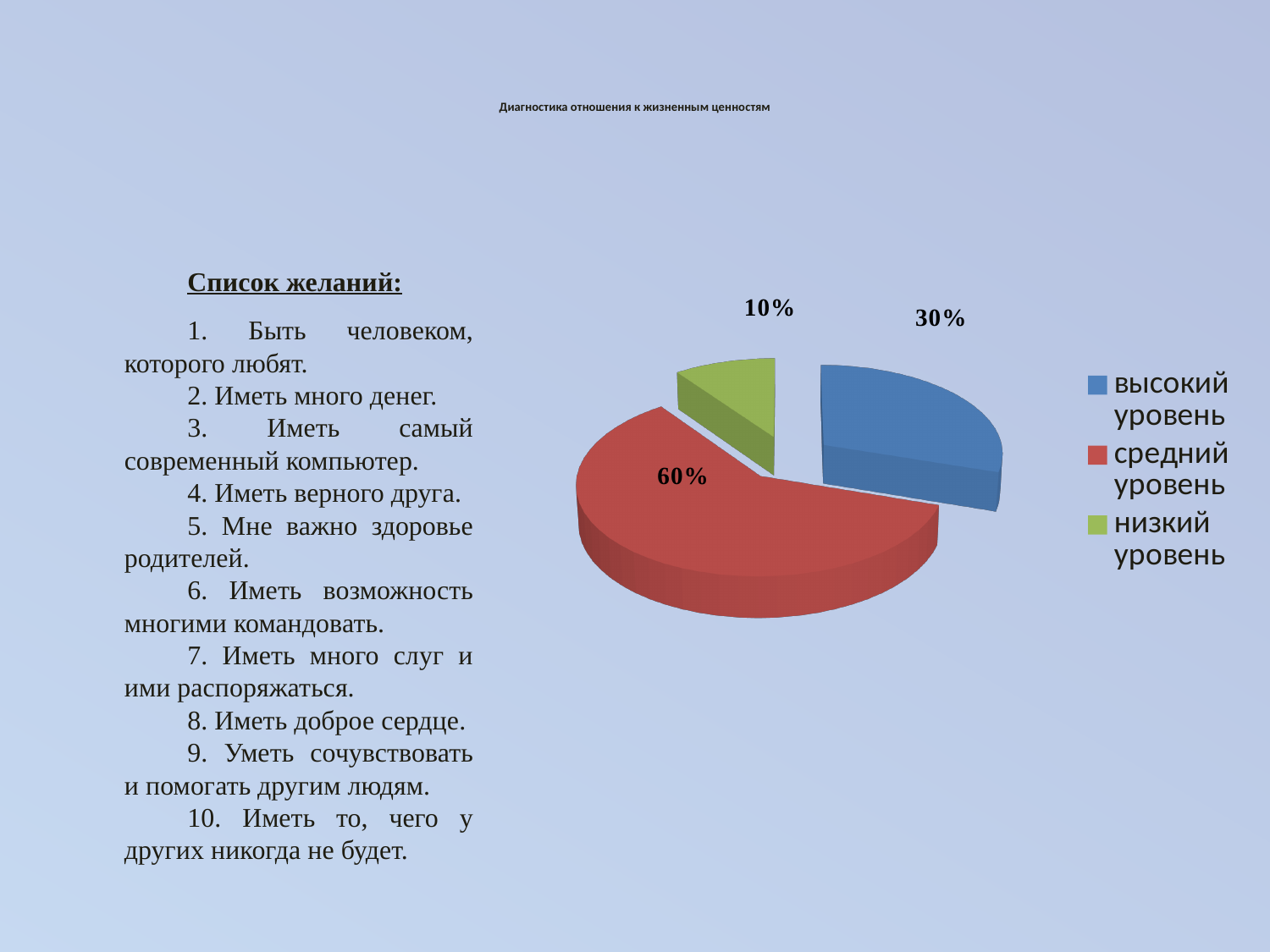
What kind of chart is shown on the slide? pie chart How many entries does the legend list? 3 Which category has the largest slice of the pie? средний уровень What share of the pie does "высокий уровень" have? 30% What colour is the slice for "средний уровень"? red What share of the pie does "низкий уровень" have? 10% Which is larger, the slice for "высокий уровень" or the slice for "низкий уровень"? высокий уровень What is the difference in percentage points between "высокий уровень" and "низкий уровень"? 20% How many slices does the pie chart have? 3 What is the difference in percentage points between "средний уровень" and "высокий уровень"? 30% Which category has the smallest slice of the pie? низкий уровень What share of the pie does "средний уровень" have? 60%